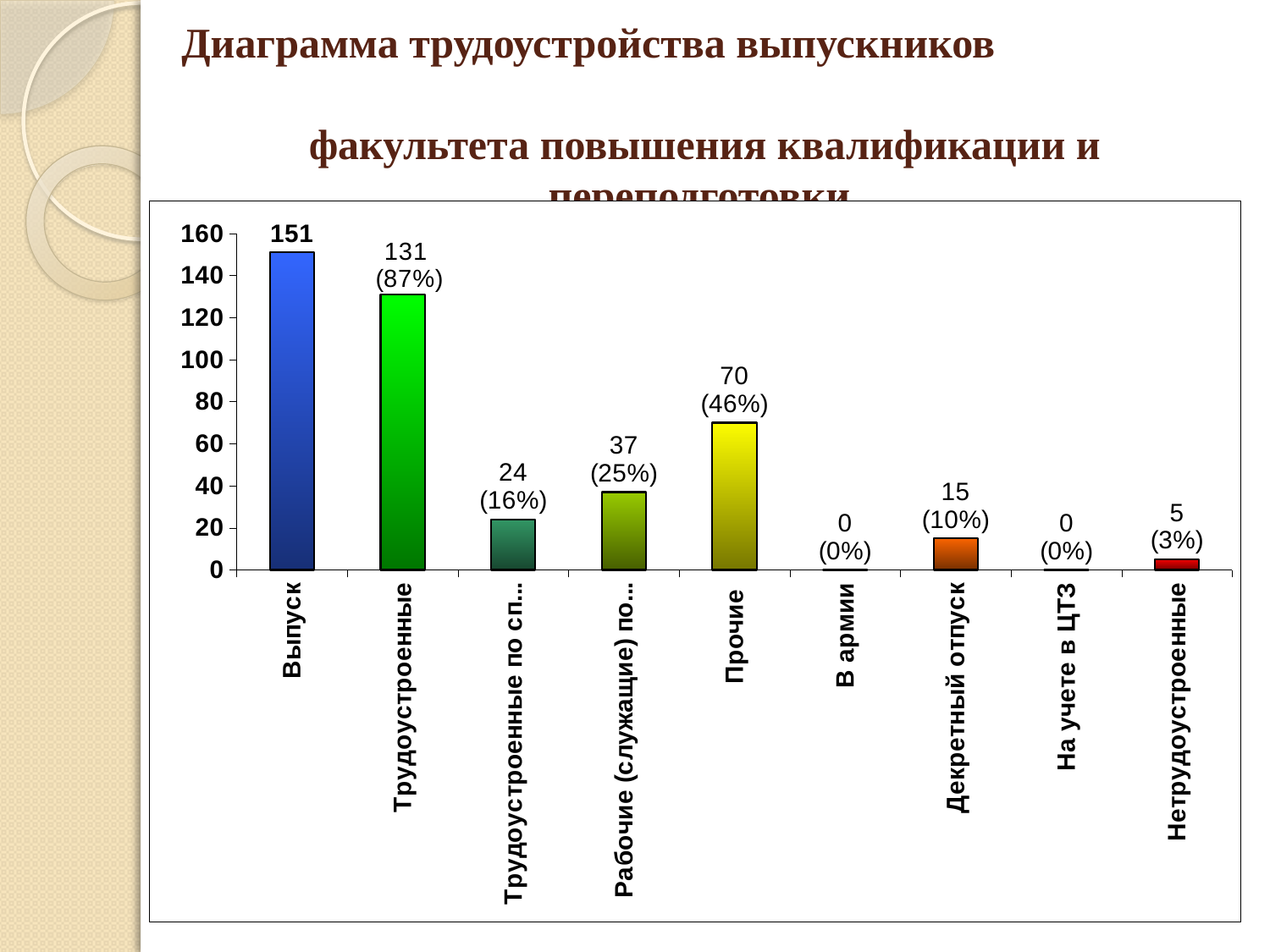
Which category has the highest value? Выпуск What is the difference between the values for Выпуск and Трудоустроенные? 20 What is the value for Выпуск? 151 What is the value for В армии? 0 What is the value for Декретный отпуск? 15 What is the value for Нетрудоустроенные? 5 What percentage is shown for Прочие? 46% What is the value for Трудоустроенные? 131 What is the difference between the values for Прочие and Нетрудоустроенные? 65 What kind of chart is shown on the slide? Bar chart How many categories are shown on the x axis? 9 Which is larger, the value for Прочие or the value for Декретный отпуск? Прочие